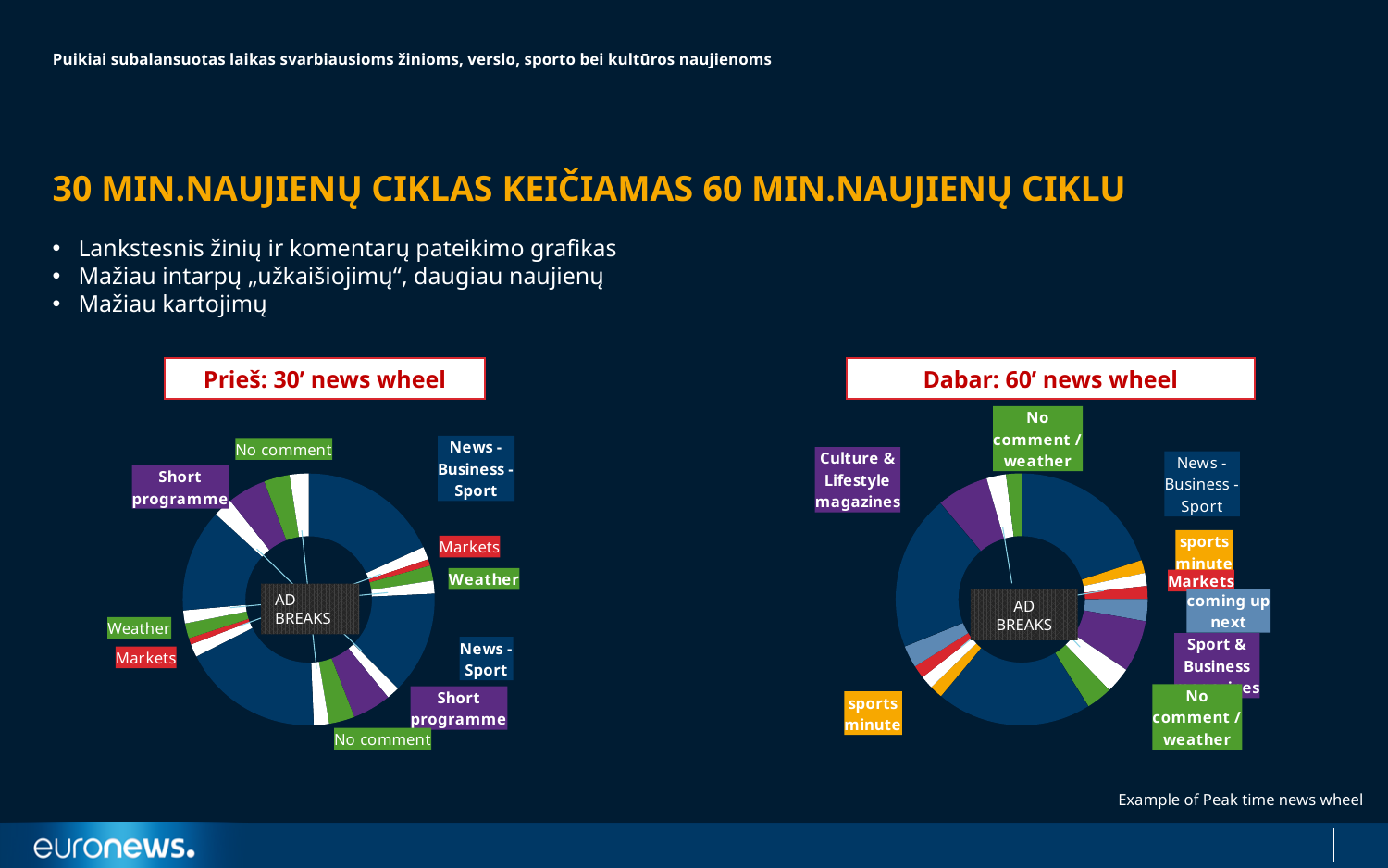
What kind of chart is the 'Prieš: 30’ news wheel' chart? doughnut chart In the 'Dabar: 60’ news wheel' chart, which segment is larger, 'Culture & Lifestyle magazines' or 'Markets'? Culture & Lifestyle magazines In the 'Prieš: 30’ news wheel' chart, which segment is larger, 'Short programme' or 'Markets'? Short programme What is the title of the chart on the right side of the slide? Dabar: 60’ news wheel In the 'Dabar: 60’ news wheel' chart, which category occupies the largest share of the wheel? News - Business - Sport In the 'Prieš: 30’ news wheel' chart, which category occupies the largest share of the wheel? News - Business - Sport What kind of chart is the 'Dabar: 60’ news wheel' chart? doughnut chart How many distinct category labels are shown around the 'Dabar: 60’ news wheel' chart? 7 How many charts are shown on the slide? 2 What text appears in the centre of both wheel charts? AD BREAKS How many distinct category labels are shown around the 'Prieš: 30’ news wheel' chart? 6